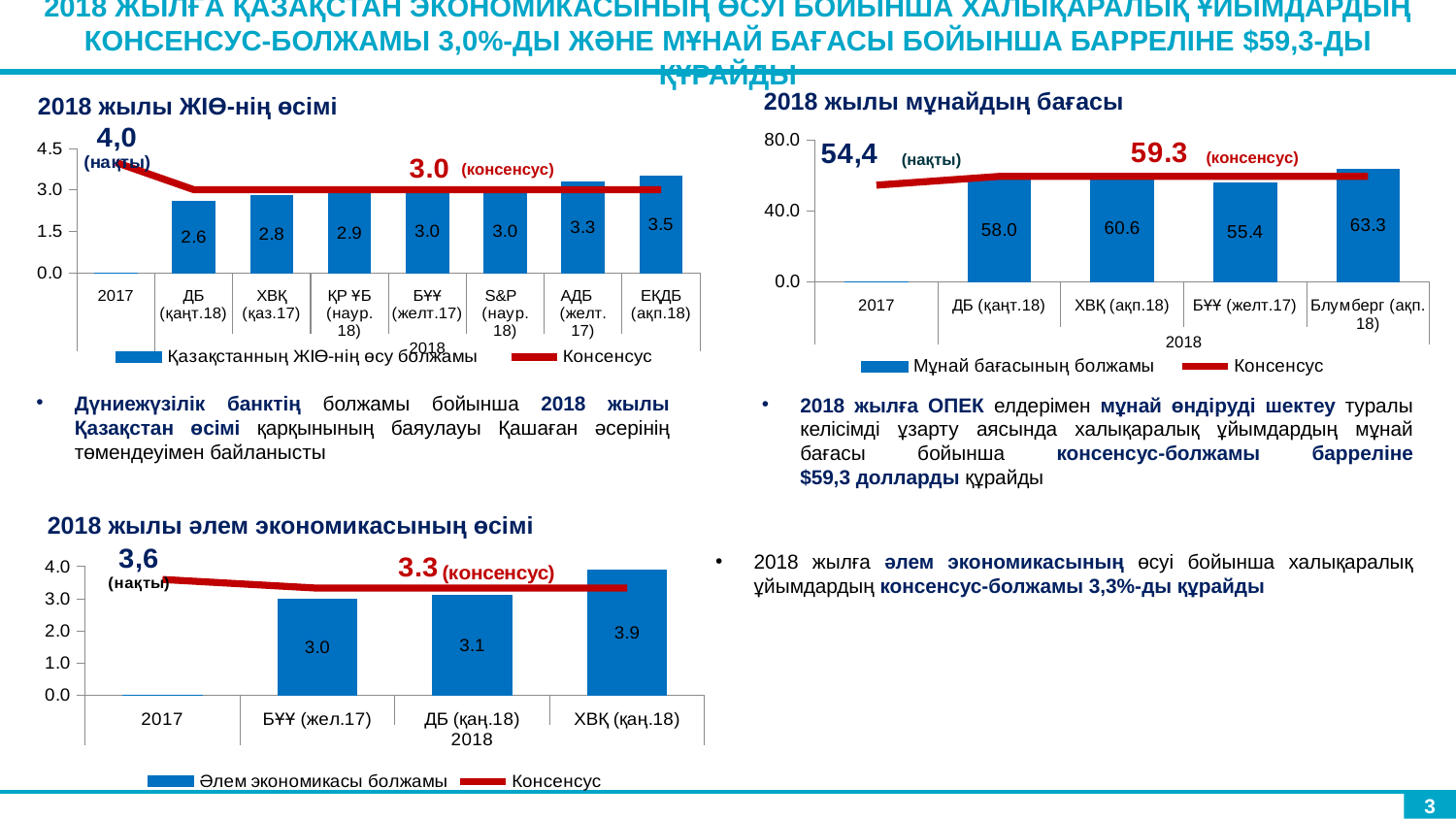
In the chart titled "2018 жылы әлем экономикасының өсімі", do the bar values rise or fall from left to right? rise In the chart titled "2018 жылы мұнайдың бағасы", what is the value for Блумберг (ақп.18)? 63.3 In the chart titled "2018 жылы мұнайдың бағасы", what is the 2017 actual value labelled "нақты"? 54,4 In the chart titled "2018 жылы мұнайдың бағасы", which forecaster has the lowest bar? БҰҰ (желт.17) In the chart titled "2018 жылы ЖІӨ-нің өсімі", what is the consensus value shown on the red line? 3.0 In the chart titled "2018 жылы ЖІӨ-нің өсімі", which forecaster has the lowest bar? ДБ (қаңт.18) In the chart titled "2018 жылы әлем экономикасының өсімі", what is the value for ХВҚ (қаң.18)? 3.9 In the chart titled "2018 жылы әлем экономикасының өсімі", how many series does the legend list? 2 In the chart titled "2018 жылы ЖІӨ-нің өсімі", what is the value for ЕҚДБ (ақп.18)? 3.5 In the chart titled "2018 жылы әлем экономикасының өсімі", which is larger: the value for ДБ (қаң.18) or БҰҰ (жел.17)? ДБ (қаң.18) In the chart titled "2018 жылы ЖІӨ-нің өсімі", how many forecaster bars are plotted for 2018? 7 In the chart titled "2018 жылы мұнайдың бағасы", what is the difference between the ХВҚ (ақп.18) and ДБ (қаңт.18) values? 2.6